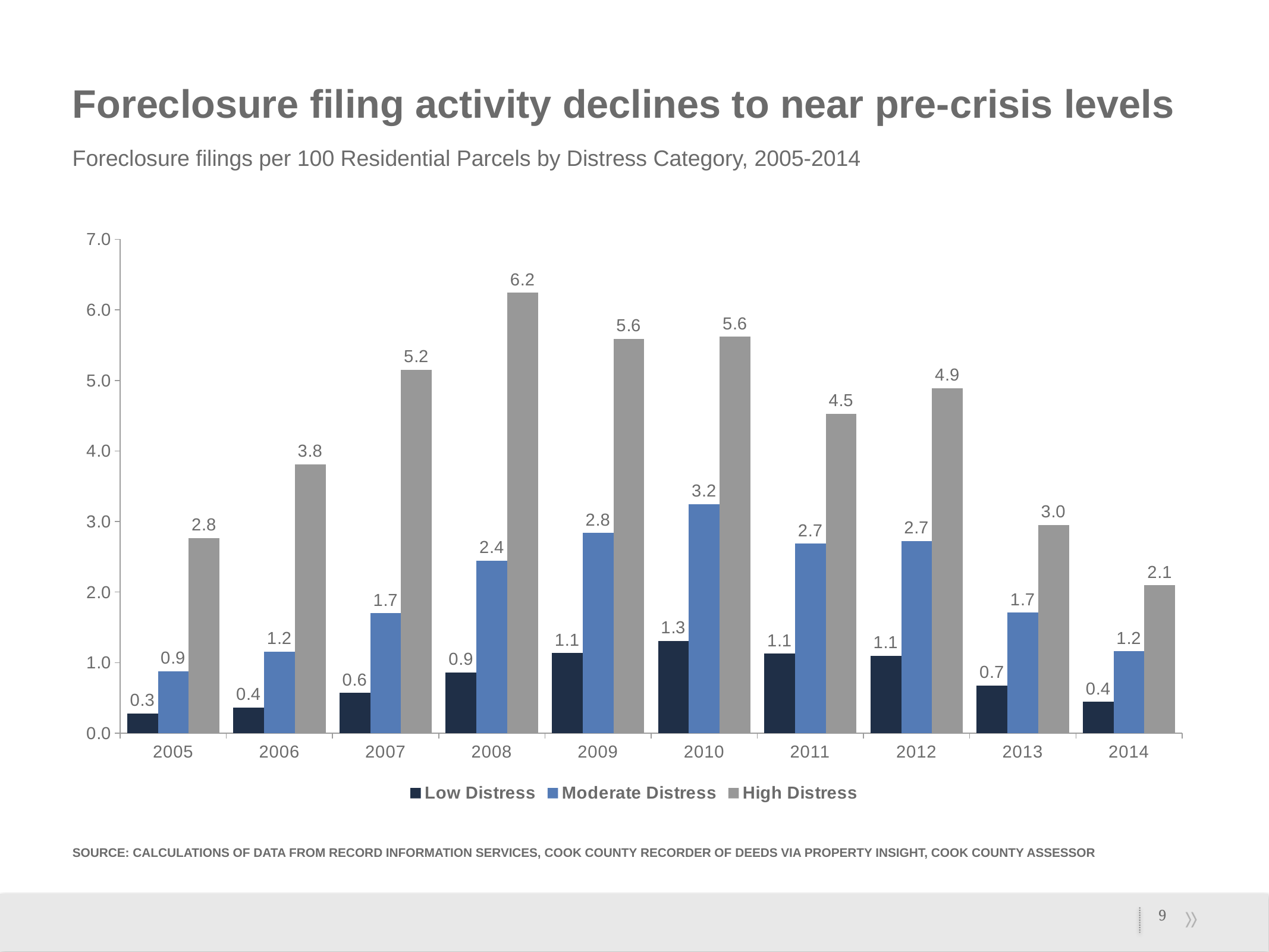
How many years are shown on the x axis? 10 What is the difference between the High Distress values for 2008 and 2014? 4.1 Which is larger, the Moderate Distress value for 2009 or for 2013? 2009 What is the High Distress value for 2008? 6.2 In which year is the High Distress value highest? 2008 What colour are the High Distress bars? Grey Do the High Distress values rise or fall from 2012 to 2014? Fall How many series does the legend list? 3 What is the Moderate Distress value for 2010? 3.2 What is the Low Distress value for 2005? 0.3 In which year is the Low Distress value lowest? 2005 What kind of chart is shown on the slide? Bar chart